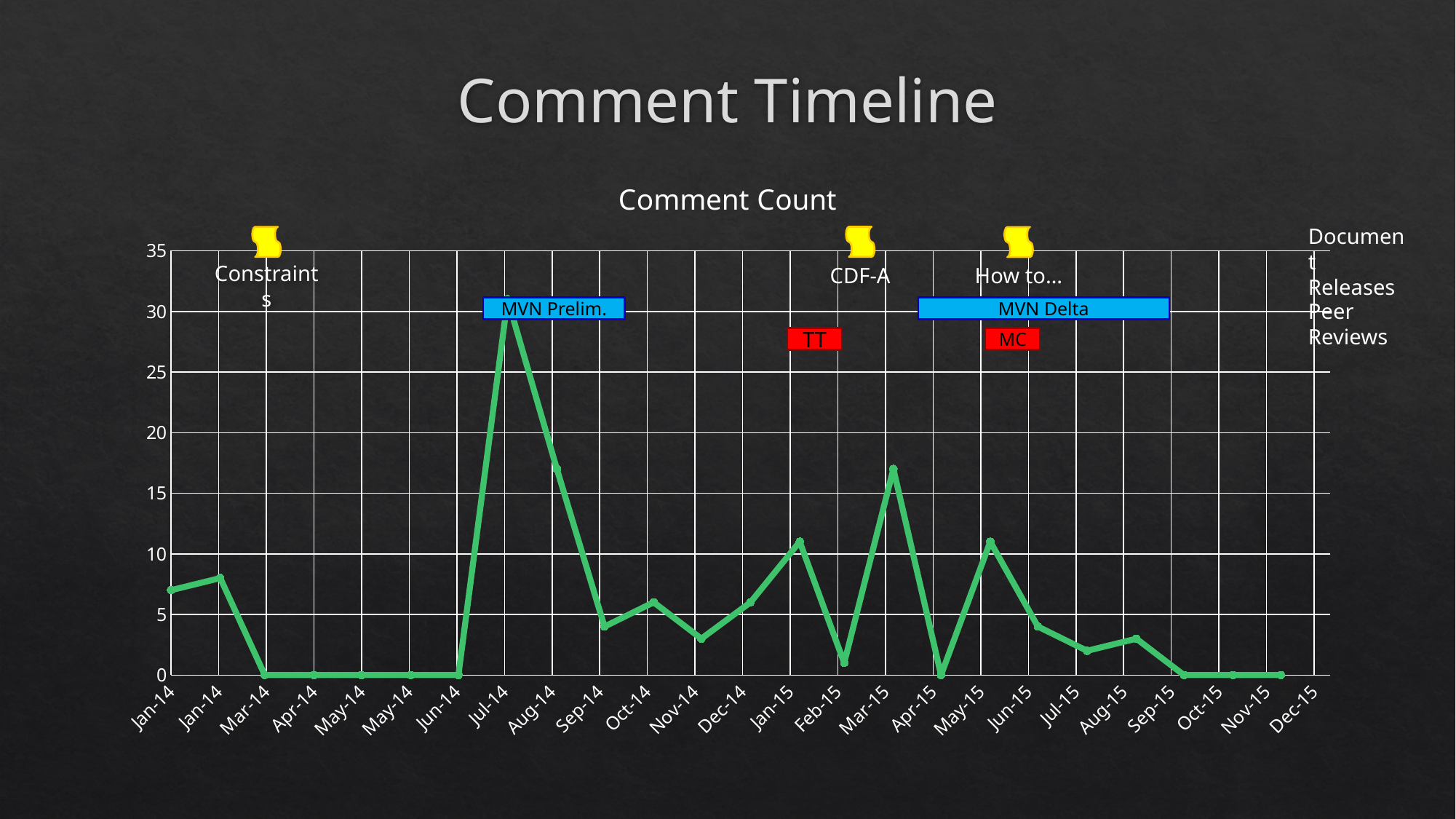
Which is larger, the comment count for Jul-14 or for Mar-15? Jul-14 What is the comment count for Mar-14? 0 Which is larger, the comment count for Aug-14 or for Sep-14? Aug-14 Is the comment count for Mar-15 greater or less than 15? greater What kind of chart is shown on the slide? line chart Does the comment count rise or fall from Jul-14 to Sep-14? fall What is the comment count for Apr-15? 0 What is the title of the chart? Comment Count Which month has the highest comment count? Jul-14 Is the comment count for Nov-14 greater or less than 5? less Is the comment count for Feb-15 greater or less than 5? less